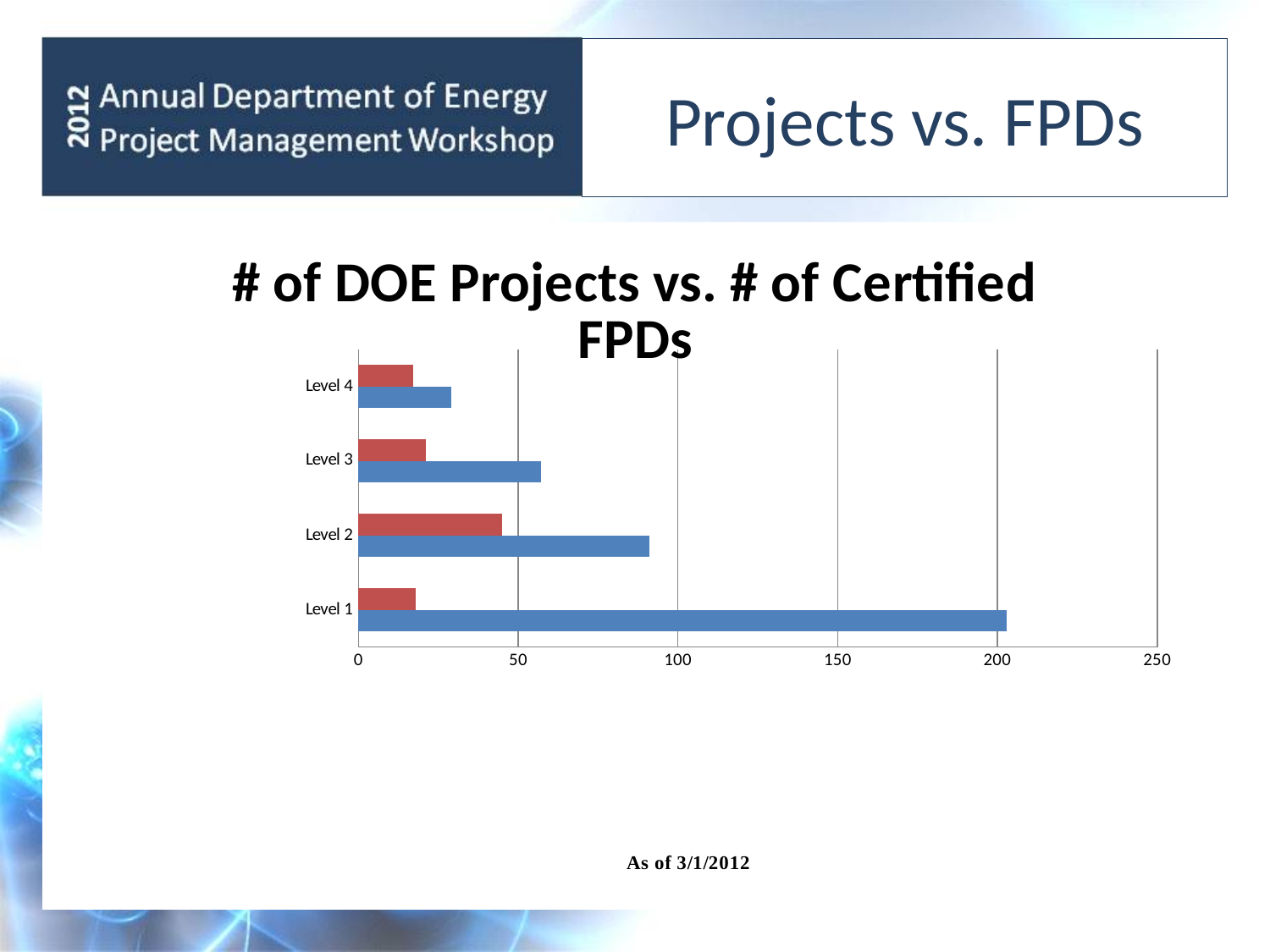
Is the red bar for Level 2 greater or less than 50? less Is the blue bar for Level 3 greater or less than 50? greater Which has the longer blue bar, Level 2 or Level 3? Level 2 What kind of chart is shown on the slide? bar chart Is the blue bar for Level 4 greater or less than 50? less How many levels (categories) are shown on the chart? 4 What is the title of the chart? # of DOE Projects vs. # of Certified FPDs Which level has the shortest blue bar? Level 4 Which level has the longest red bar? Level 2 Which level has the longest blue bar? Level 1